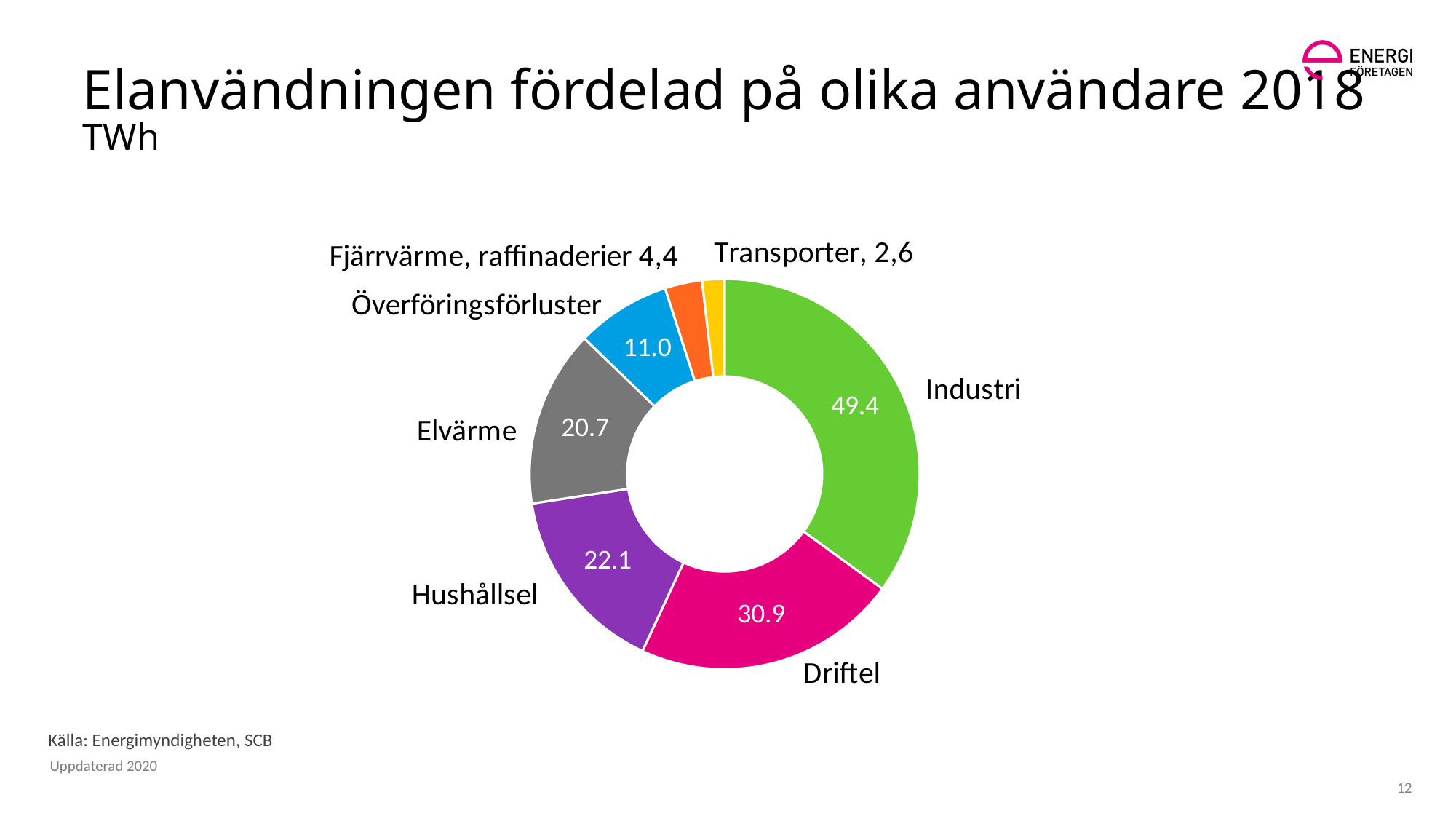
What kind of chart is shown on the slide? Pie (doughnut) chart What is the value for Industri? 49.4 Which category has the largest share of the chart? Industri What unit is stated under the chart title? TWh How many categories are shown in the chart? 7 Which is larger, the value for Elvärme or the value for Överföringsförluster? Elvärme Which category has the smallest share of the chart? Transporter What is the value for Driftel? 30.9 What is the value for Transporter? 2,6 What is the value for Överföringsförluster? 11.0 What is the difference between the values for Industri and Driftel? 18.5 What is the difference between the values for Hushållsel and Elvärme? 1.4